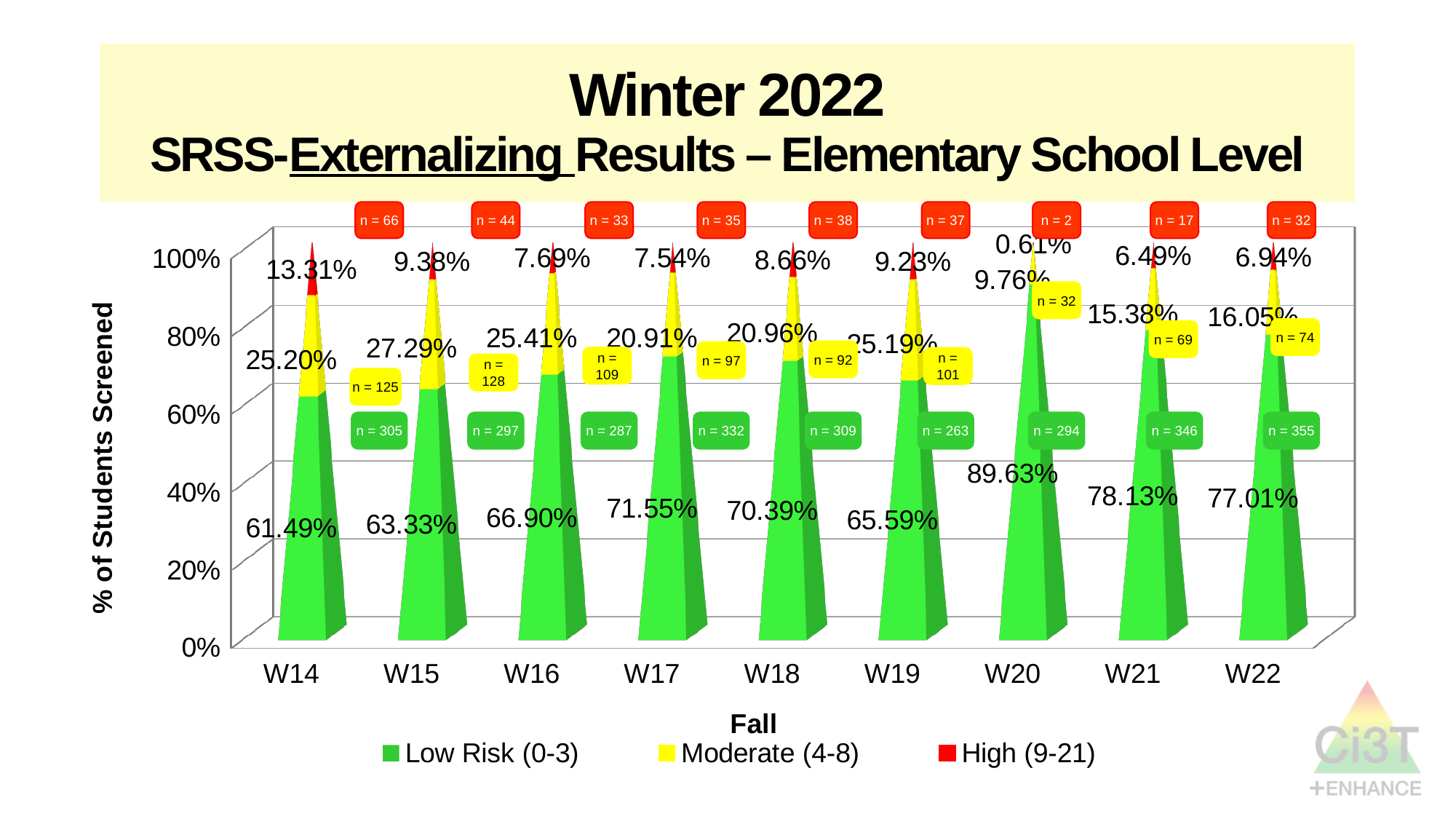
What is the High (9-21) percentage for W20? 0.61% How many students are in the Low Risk (0-3) group at W22 (the n value)? n = 355 What kind of chart is shown on the slide? Stacked bar chart How many series does the legend list? 3 Which school has the lowest Moderate (4-8) percentage? W20 Which school has the highest Low Risk (0-3) percentage? W20 What percentage of students screened at W14 were in the Low Risk (0-3) category? 61.49% What is the Moderate (4-8) percentage for W17? 20.91% How many schools are shown on the x axis? 9 What is the difference between the Low Risk (0-3) percentages for W21 and W22? 1.12 percentage points Which is larger, the Moderate (4-8) percentage for W15 or for W16? W15 Which school has the highest High (9-21) percentage? W14